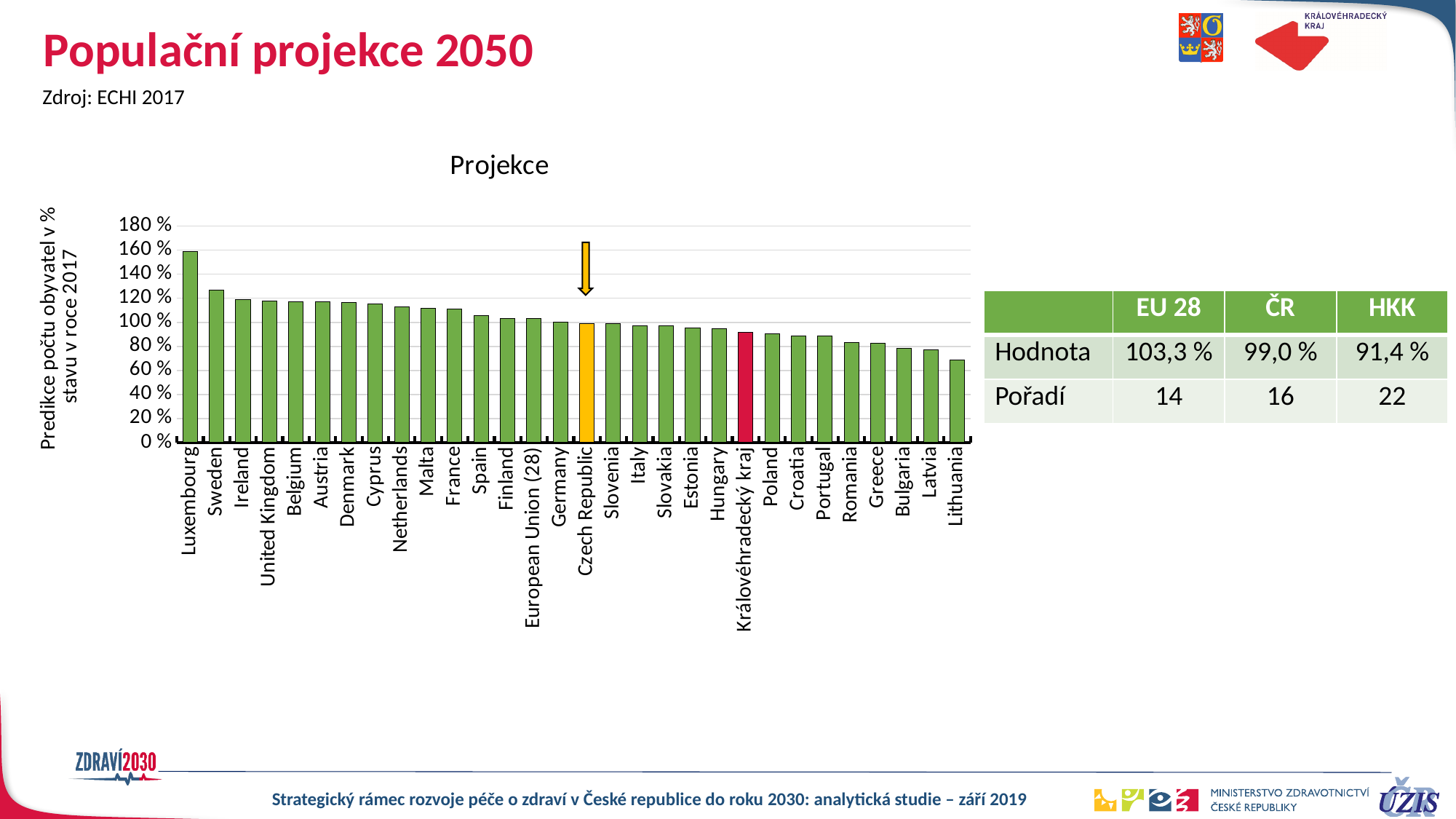
What is the value for European Union (28) (EU 28) according to the table? 103,3 % Which category has the lowest value in the chart? Lithuania Is the value for Lithuania greater or less than 80 %? less Which category has the highest value in the chart? Luxembourg What type of chart is shown on the slide? bar chart How many categories (bars) are plotted in the chart? 30 What is the value for Královéhradecký kraj (HKK) according to the table? 91,4 % What is the value for Czech Republic (ČR) according to the table? 99,0 % Which is larger, the value for Czech Republic or the value for Královéhradecký kraj? Czech Republic What is the title of the chart? Projekce Do the values generally rise or fall from left to right along the x axis? fall Is the value for Luxembourg greater or less than 140 %? greater